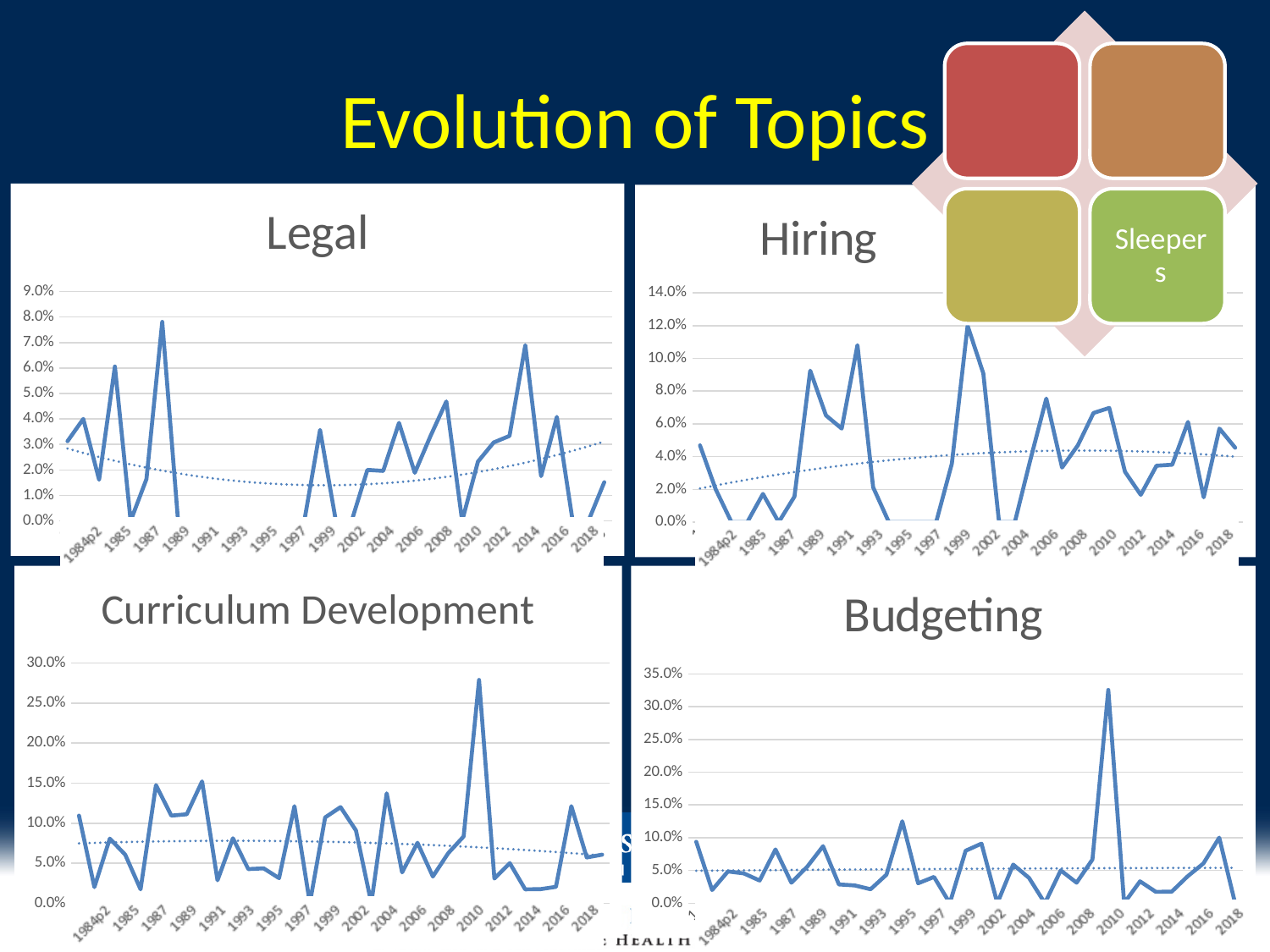
In the Budgeting chart, is the value for 2018 greater or less than 5.0%? less In the Budgeting chart, is the highest value greater or less than 30.0%? greater What kind of chart is the Legal chart? line chart How many charts are shown on the slide? 4 In the Legal chart, which year has the highest value? 1989 In the Legal chart, is the highest value greater or less than 7.0%? greater What are the titles of the four charts on the slide? Legal, Hiring, Curriculum Development, Budgeting In the Curriculum Development chart, which year has the highest value? 2010